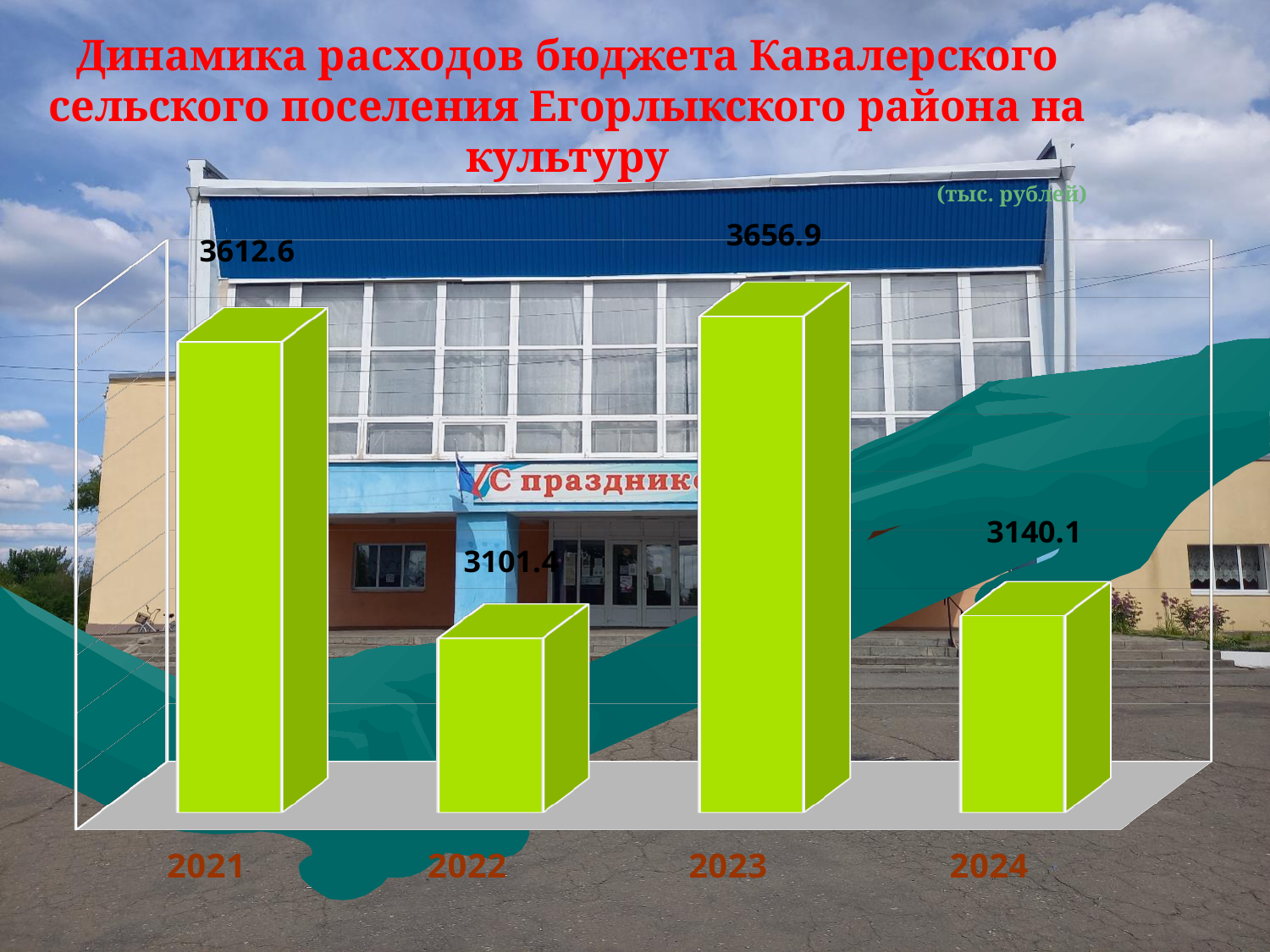
Which is larger, the value for 2024 or the value for 2022? 2024 What is the value for 2024? 3140.1 How many years are shown on the chart? 4 What is the difference between the values for 2023 and 2021? 44.3 What is the value for 2022? 3101.4 What is the value for 2021? 3612.6 Which year has the lowest value? 2022 In what units are the values on the chart given? тыс. рублей Which year has the highest value? 2023 What kind of chart is shown on the slide? bar chart What is the difference between the values for 2021 and 2022? 511.2 What is the value for 2023? 3656.9